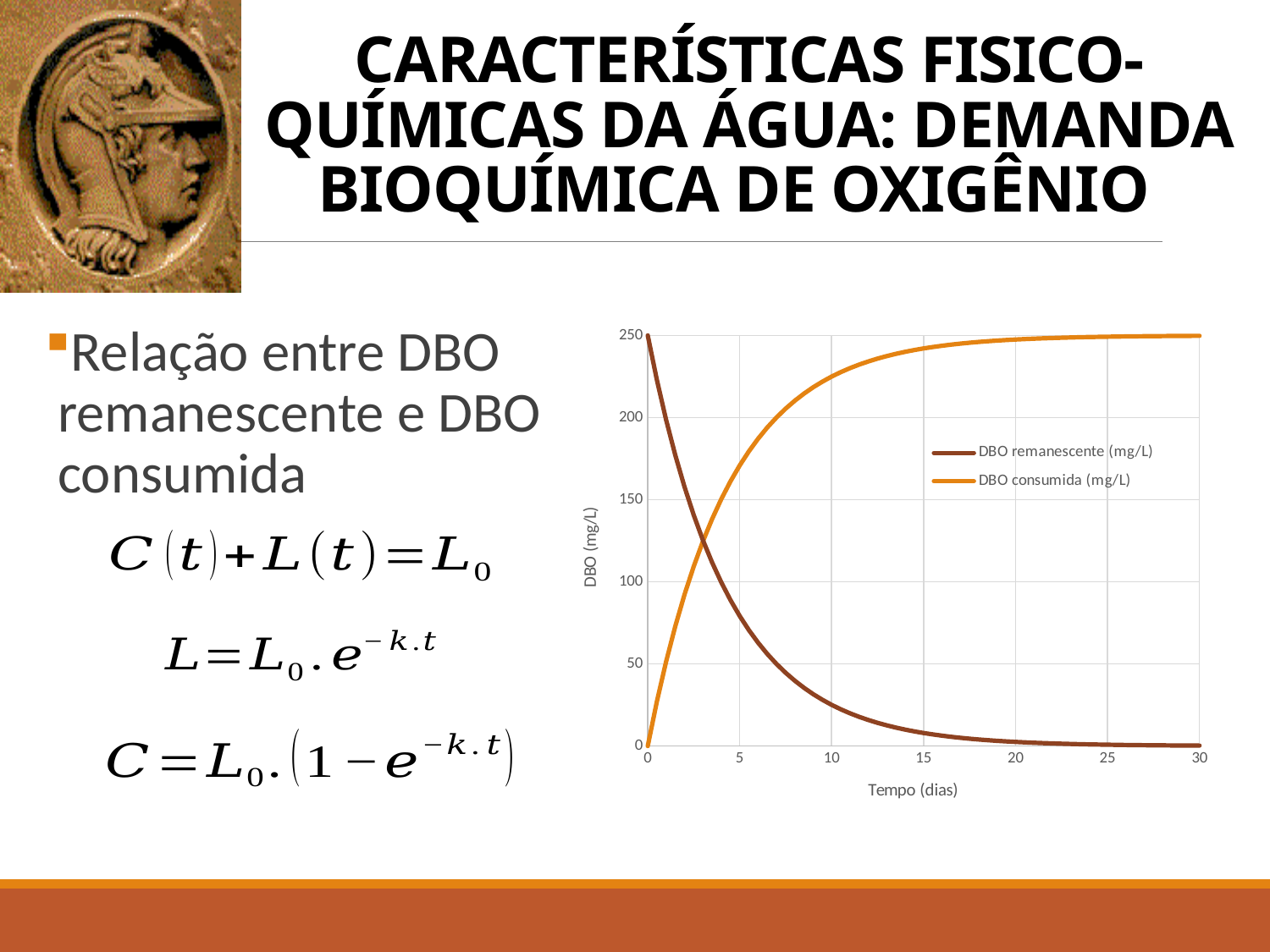
Does the DBO consumida (mg/L) series rise or fall as Tempo (dias) increases? rise What is the value of DBO remanescente (mg/L) at 0 days? 250 What kind of chart is shown on the slide? line chart Is the value of DBO remanescente (mg/L) at 10 days greater or less than 50? less How many series does the chart legend list? 2 What is the value of DBO consumida (mg/L) at 0 days? 0 Does the DBO remanescente (mg/L) series rise or fall as Tempo (dias) increases? fall Is the value of DBO consumida (mg/L) at 10 days greater or less than 200? greater Is the value of DBO remanescente (mg/L) at 20 days greater or less than 50? less At 20 days, which series has the higher value, DBO remanescente (mg/L) or DBO consumida (mg/L)? DBO consumida (mg/L) What is the title of the x axis of the chart? Tempo (dias)